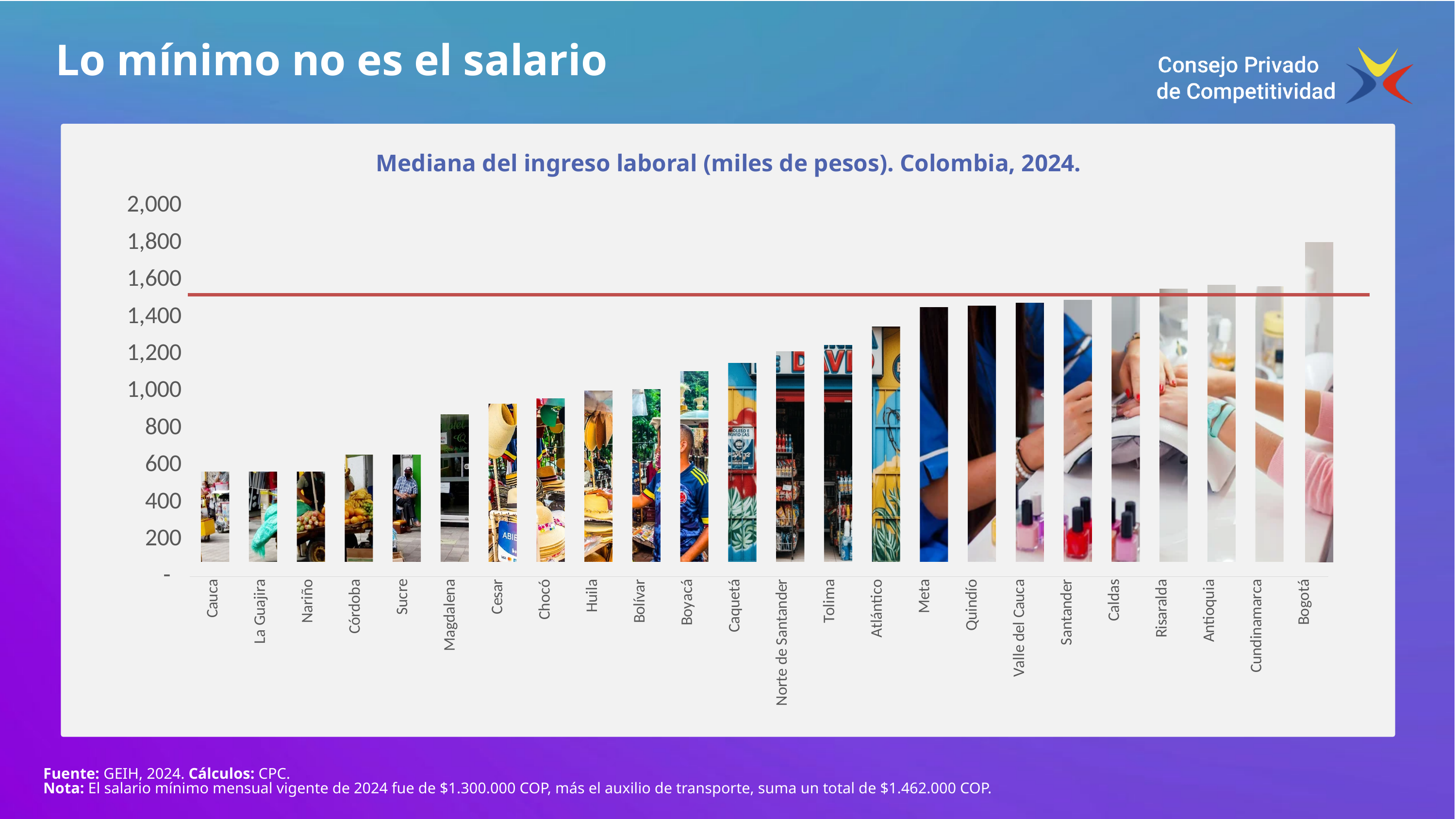
Is the value for Cauca greater or less than 800? less Which department has the highest median labour income in the chart? Bogotá What kind of chart is shown on the slide? bar chart What is the title of the chart? Mediana del ingreso laboral (miles de pesos). Colombia, 2024. Is the value for Bogotá greater or less than 1,600? greater Which has a higher median labour income, Atlántico or Tolima? Atlántico Is the value for Atlántico greater or less than 1,200? greater Do the bar values rise or fall from left to right along the x axis? rise Which has a higher median labour income, Bogotá or Cauca? Bogotá How many departments are shown on the x axis of the chart? 24